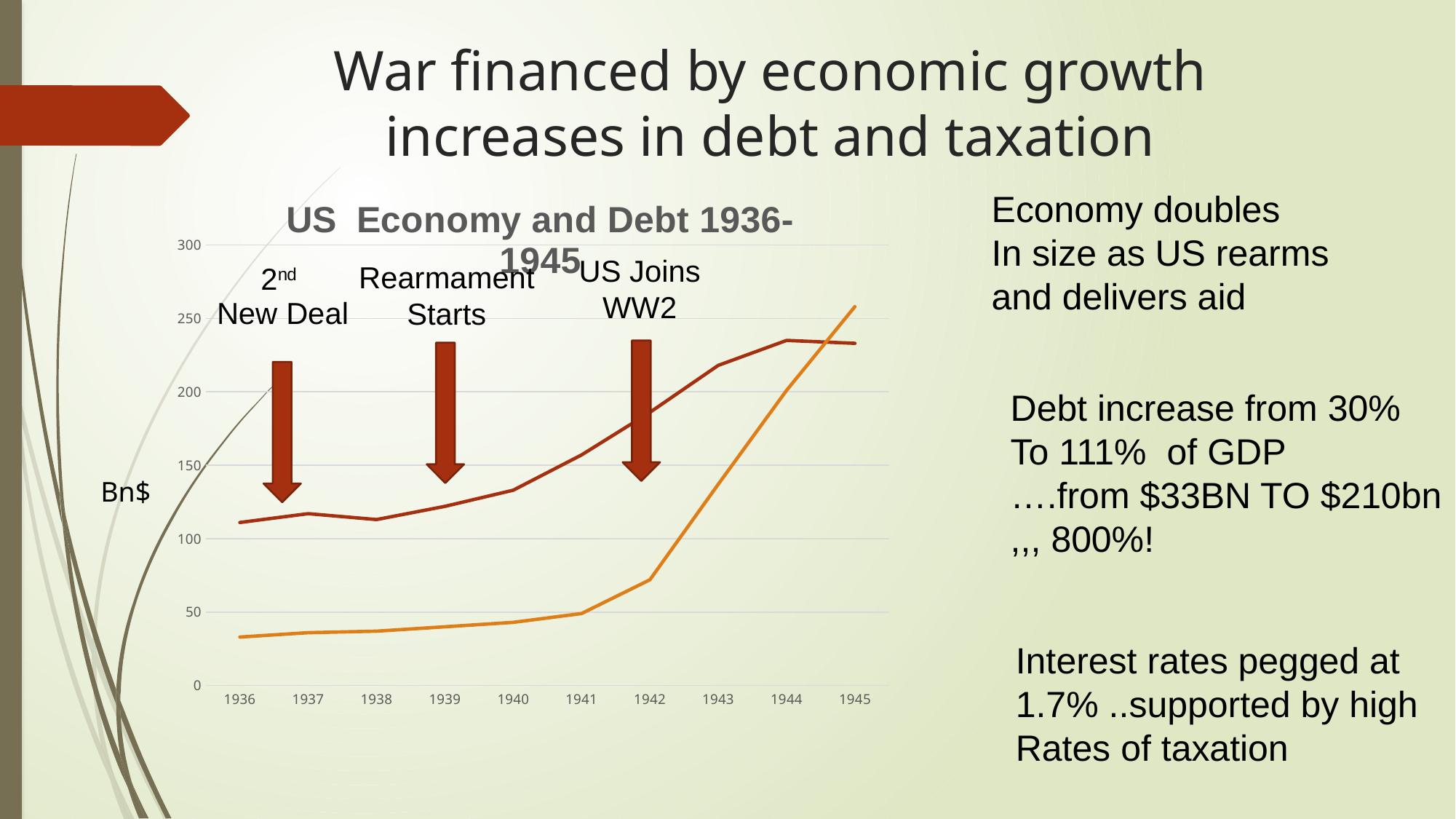
What kind of chart is shown on the slide? line chart Does the orange line rise or fall from 1936 to 1945? rise Is the value of the dark red line in 1944 greater or less than 200? greater Is the value of the orange line in 1945 greater or less than 200? greater What is the title of the chart? US Economy and Debt 1936-1945 Is the value of the dark red line in 1936 greater or less than 100? greater What unit label is shown next to the vertical axis of the chart? Bn$ How many years are plotted along the x axis of the chart? 10 In 1936, which line has the higher value, the dark red line or the orange line? dark red line In which year does the orange line reach its highest value? 1945